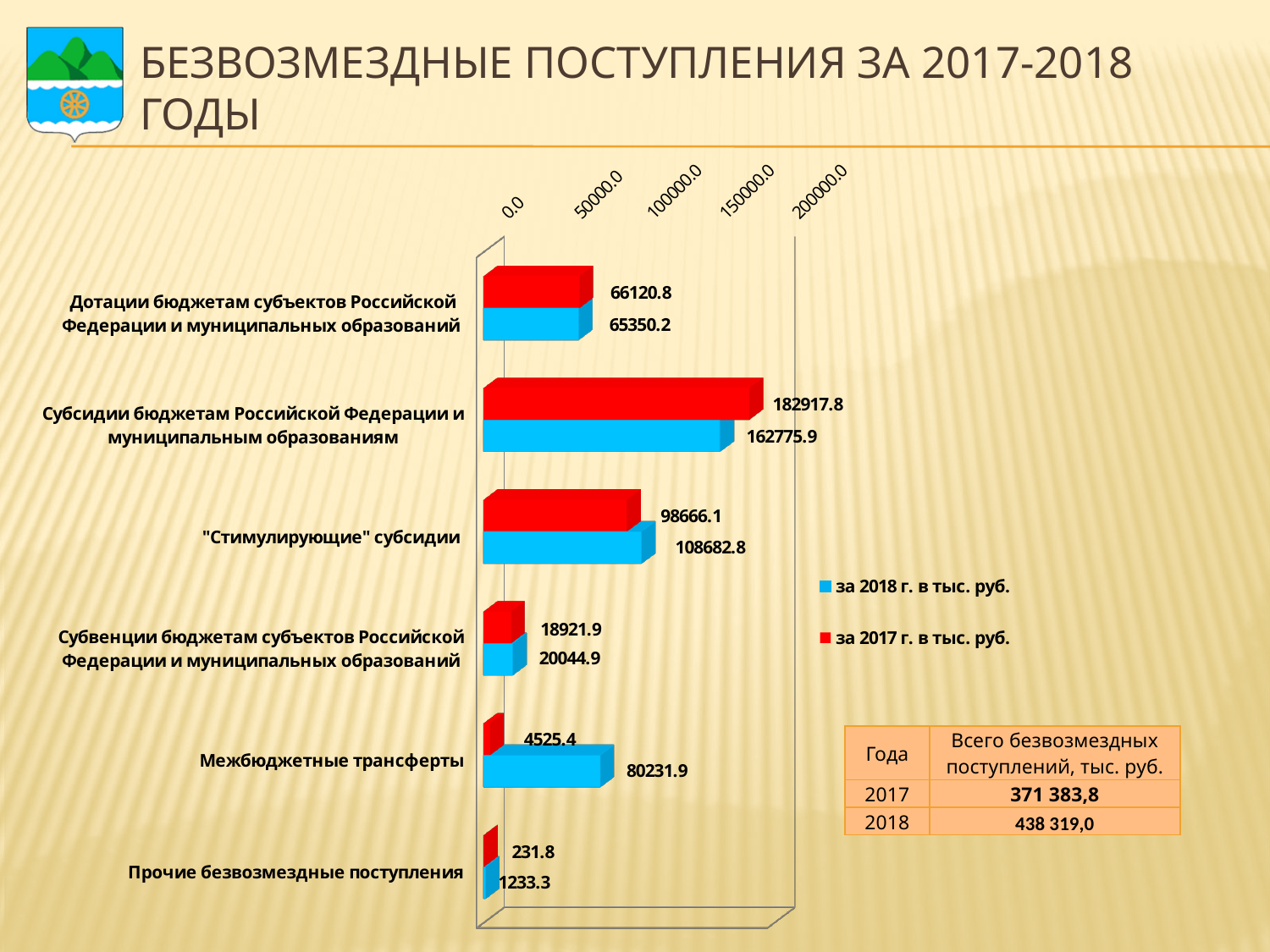
Which category has the highest value for the series "за 2018 г. в тыс. руб."? Субсидии бюджетам Российской Федерации и муниципальным образованиям How many series does the chart legend list? 2 What is the difference between the 2018 and 2017 values for "Межбюджетные трансферты"? 75706.5 Which colour represents the series "за 2017 г. в тыс. руб." in the chart? red How many categories are shown on the chart? 6 What is the value for "Субсидии бюджетам Российской Федерации и муниципальным образованиям" for the series "за 2017 г. в тыс. руб."? 182917.8 What is the value for "Межбюджетные трансферты" for the series "за 2018 г. в тыс. руб."? 80231.9 What type of chart is shown on the slide? bar chart What is the difference between the 2017 and 2018 values for "Субсидии бюджетам Российской Федерации и муниципальным образованиям"? 20141.9 Which category has the lowest value for the series "за 2017 г. в тыс. руб."? Прочие безвозмездные поступления What is the value for "Прочие безвозмездные поступления" for the series "за 2017 г. в тыс. руб."? 231.8 For ""Стимулирующие" субсидии", which series has the larger value, "за 2017 г. в тыс. руб." or "за 2018 г. в тыс. руб."? за 2018 г. в тыс. руб.